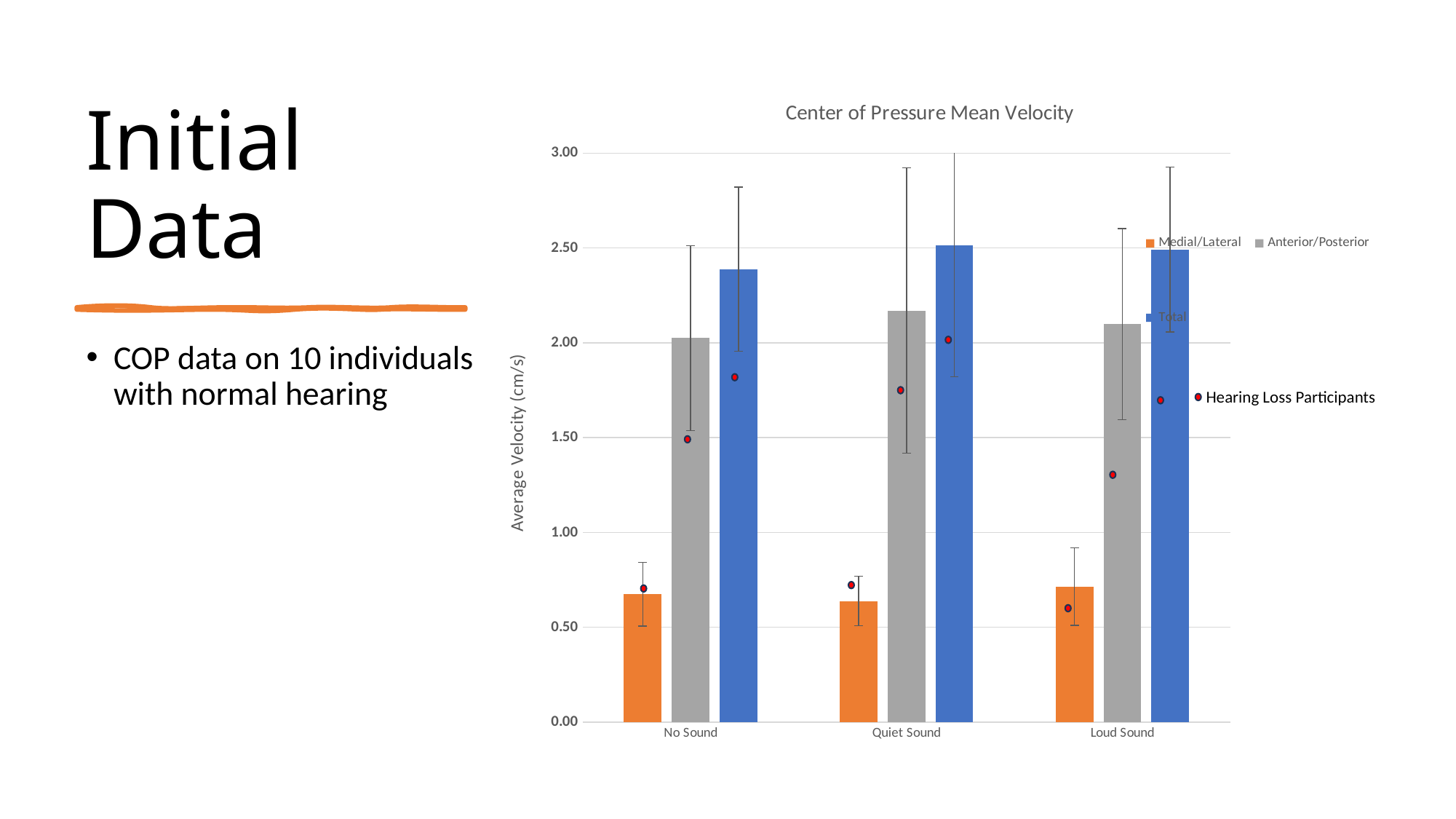
Is the Medial/Lateral value for No Sound greater or less than 1.00? less Is the Total value for No Sound greater or less than 2.50? less What is the title of the chart? Center of Pressure Mean Velocity In the No Sound condition, which is larger: the Medial/Lateral bar or the Total bar? Total What is the label of the vertical axis? Average Velocity (cm/s) What type of chart is shown on the slide? bar chart How many sound conditions are shown on the x axis? 3 Is the Anterior/Posterior value for Quiet Sound greater or less than 2.00? greater In the Quiet Sound condition, which is larger: the Anterior/Posterior bar or the Total bar? Total How many entries does the legend list? 4